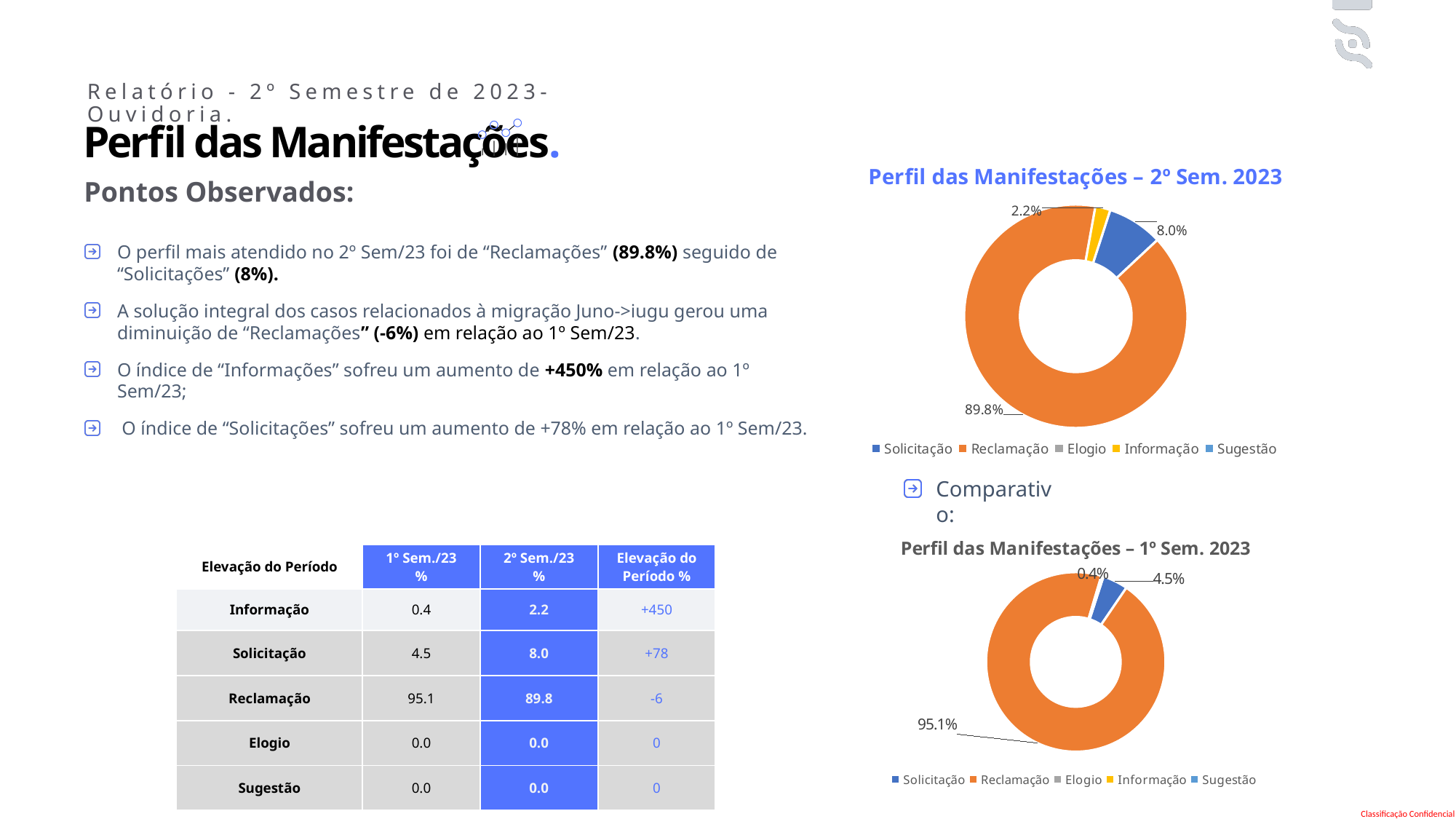
In the chart titled "Perfil das Manifestações – 2º Sem. 2023", what share does Informação have? 2.2% What type of chart is the one titled "Perfil das Manifestações – 1º Sem. 2023"? Donut (pie) chart In the chart titled "Perfil das Manifestações – 1º Sem. 2023", what share does Solicitação have? 4.5% In the chart titled "Perfil das Manifestações – 1º Sem. 2023", what share does Reclamação have? 95.1% In the chart titled "Perfil das Manifestações – 1º Sem. 2023", what share does Informação have? 0.4% In the chart titled "Perfil das Manifestações – 1º Sem. 2023", which is larger, Solicitação or Informação? Solicitação In the chart titled "Perfil das Manifestações – 2º Sem. 2023", what share does Solicitação have? 8.0% In the chart titled "Perfil das Manifestações – 2º Sem. 2023", what share does Reclamação have? 89.8% How many entries does the legend of the chart titled "Perfil das Manifestações – 2º Sem. 2023" list? 5 In the chart titled "Perfil das Manifestações – 2º Sem. 2023", what is the difference between the Solicitação and Informação shares? 5.8% In the chart titled "Perfil das Manifestações – 1º Sem. 2023", which labelled category has the smallest slice? Informação In the chart titled "Perfil das Manifestações – 2º Sem. 2023", which category has the largest slice? Reclamação